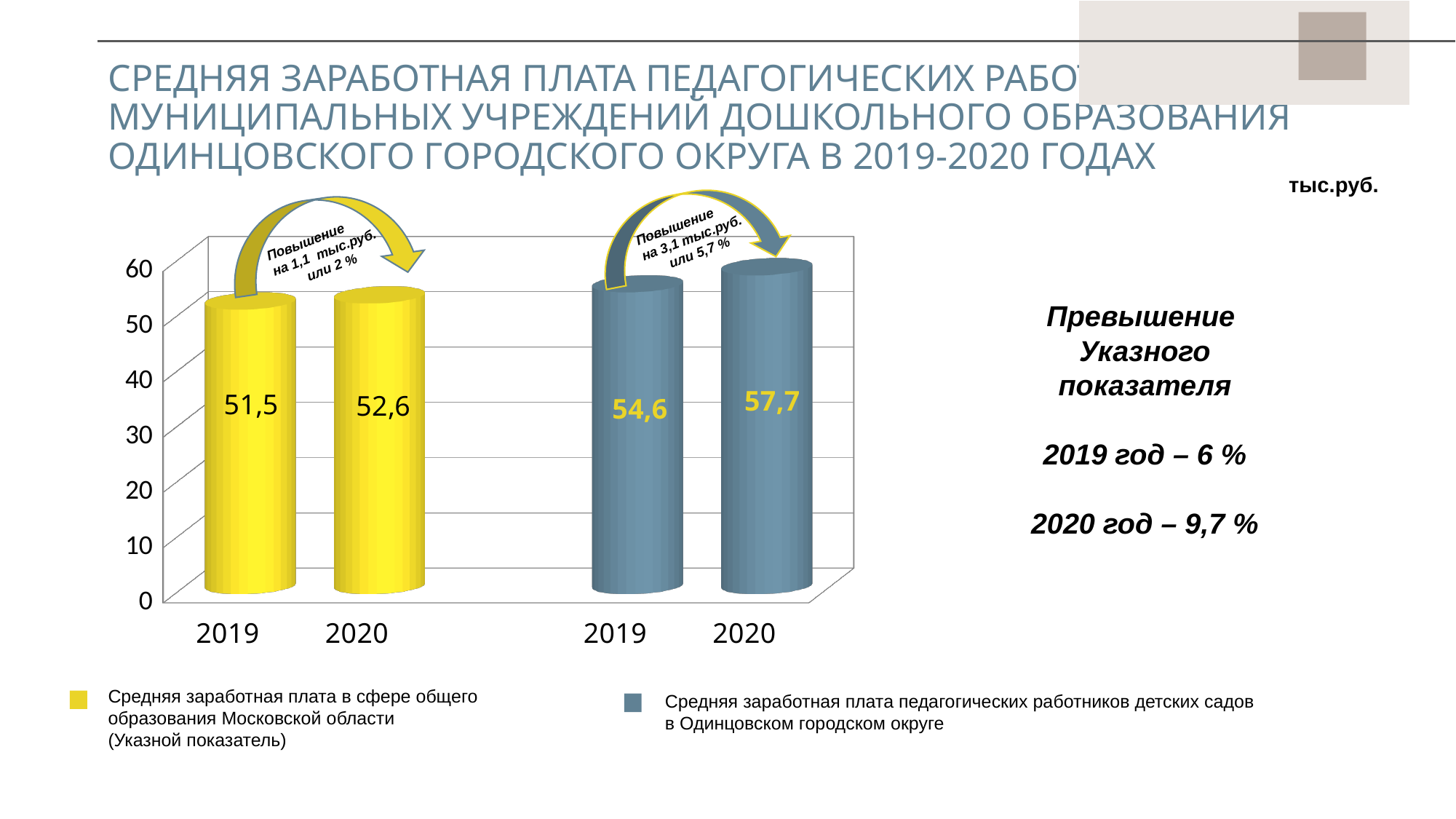
What is the value of the blue bar (педагогических работников детских садов в Одинцовском городском округе) for 2019? 54,6 Which bar has the highest value on the chart? 2020 (blue, Одинцовский городской округ), 57,7 What is the difference between the yellow 2020 bar and the yellow 2019 bar? 1,1 What is the value of the yellow bar (Указной показатель) for 2020? 52,6 Which bar has the lowest value on the chart? 2019 (yellow, Указной показатель), 51,5 Which is larger in 2020: the yellow bar (Указной показатель) or the blue bar (Одинцовский городской округ)? the blue bar (Одинцовский городской округ) What is the value of the yellow bar (Средняя заработная плата в сфере общего образования Московской области) for 2019? 51,5 What is the difference between the blue 2020 bar and the blue 2019 bar? 3,1 What is the value of the blue bar (педагогических работников детских садов в Одинцовском городском округе) for 2020? 57,7 How many series does the legend list? 2 What kind of chart is shown on the slide? bar chart How many bars are plotted on the chart? 4